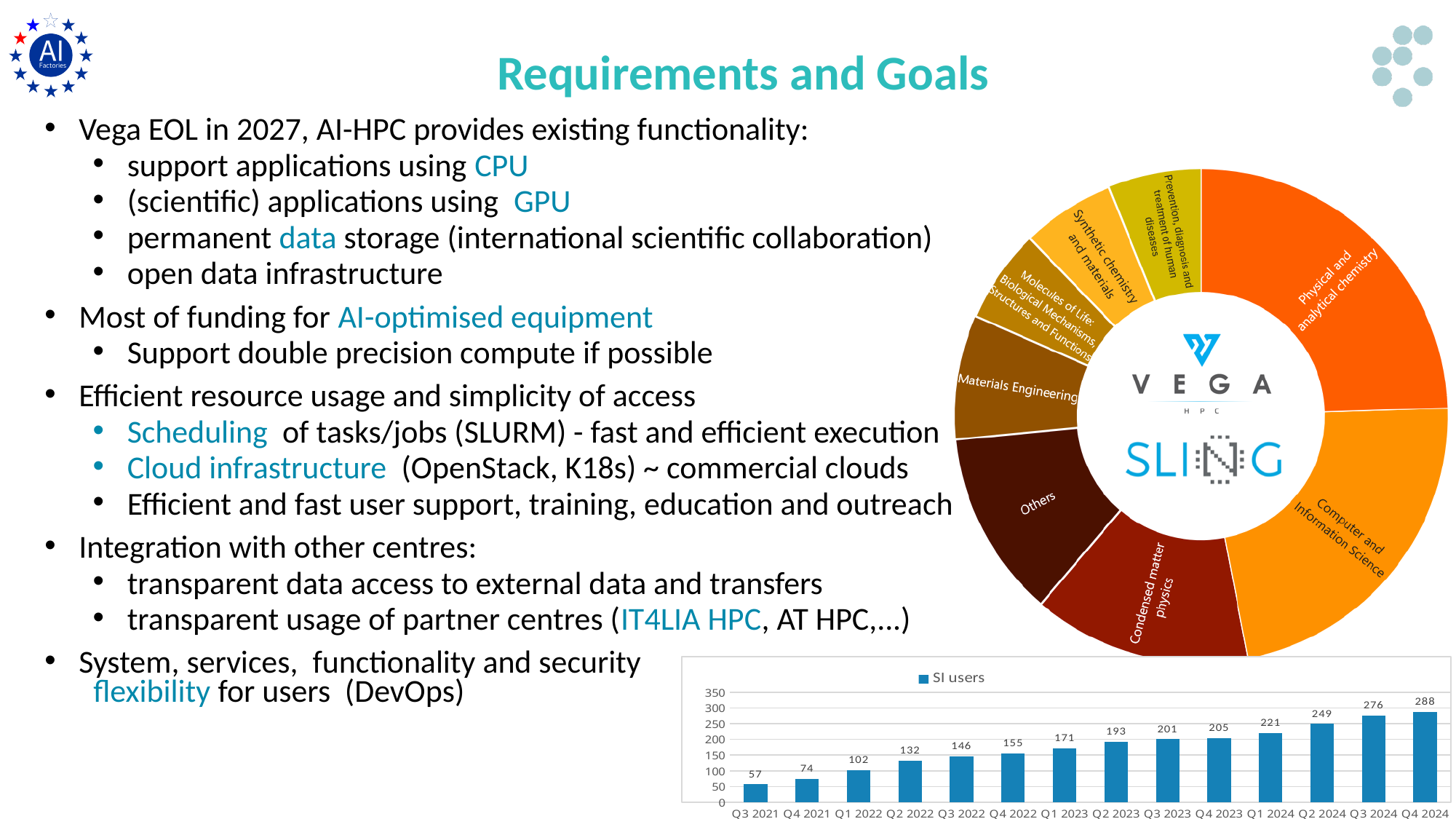
On the donut chart with the VEGA and SLING logos, which category has the largest slice? Physical and analytical chemistry On the SI users bar chart, do the values rise or fall from Q3 2021 to Q4 2024? rise On the SI users bar chart, what is the value for Q3 2021? 57 On the SI users bar chart, what is the difference between the values for Q2 2024 and Q1 2024? 28 On the SI users bar chart, which quarter has the highest value? Q4 2024 On the SI users bar chart, what is the value for Q1 2023? 171 On the donut chart with the VEGA and SLING logos, which slice is larger: Physical and analytical chemistry or Materials Engineering? Physical and analytical chemistry On the SI users bar chart, how many quarters are shown on the x axis? 14 On the SI users bar chart, what is the difference between the values for Q4 2024 and Q3 2021? 231 What kind of chart is the SI users chart at the bottom right of the slide? bar chart On the SI users bar chart, what is the value for Q4 2024? 288 On the SI users bar chart, which quarter has the lowest value? Q3 2021